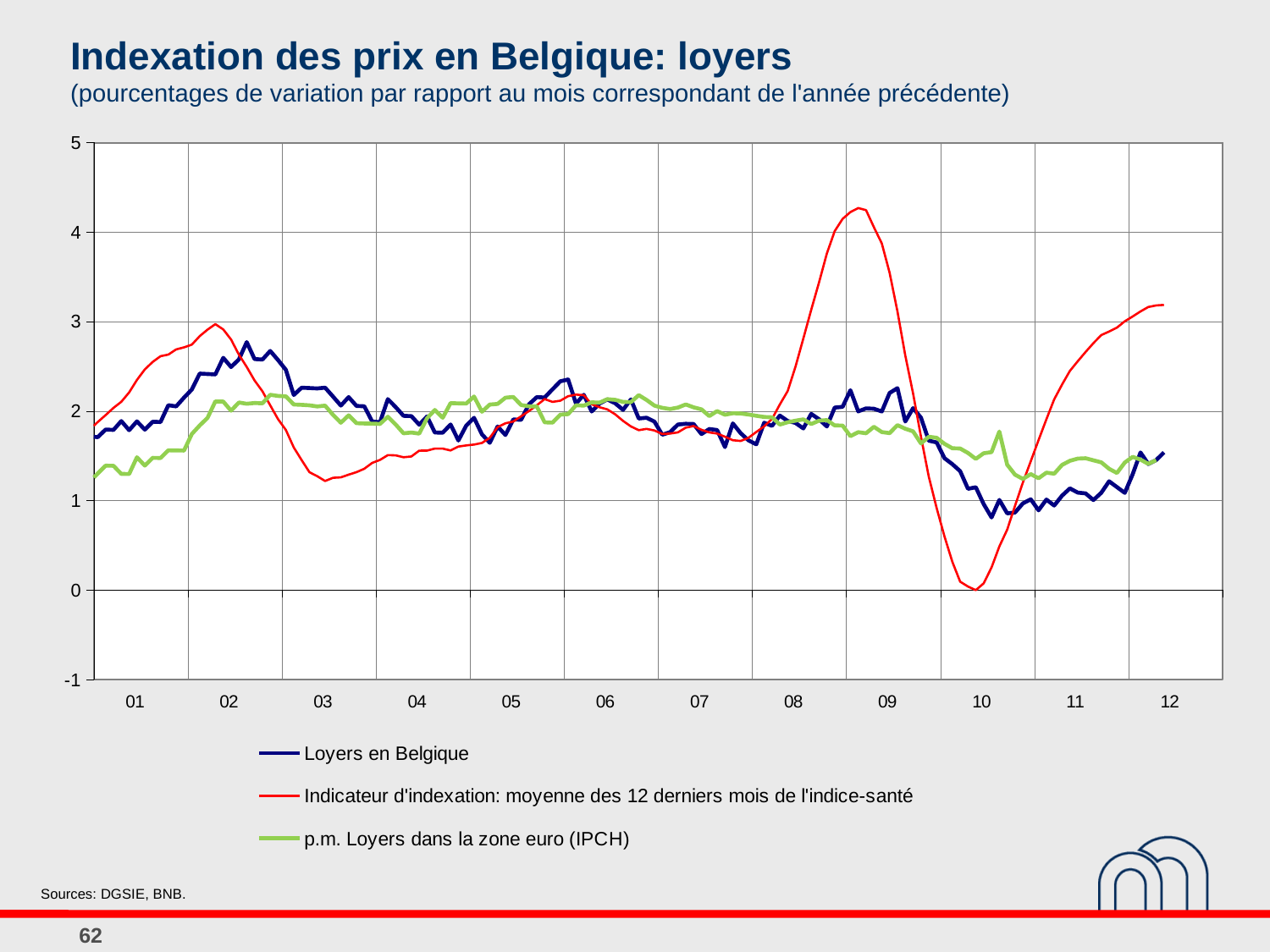
What is the title of the chart? Indexation des prix en Belgique: loyers What kind of chart is shown on the slide? line chart Is the lowest value of 'Indicateur d'indexation' around 03 greater or less than 2? less Which series reaches the highest value on the chart? Indicateur d'indexation: moyenne des 12 derniers mois de l'indice-santé How many series does the legend list? 3 Which series is drawn in green? p.m. Loyers dans la zone euro (IPCH) Is the peak value of the 'Indicateur d'indexation' series around 09 greater or less than 4? greater How many year labels are shown on the x axis? 12 Does the 'Indicateur d'indexation' series rise or fall between 10 and 12? rise Is the value of the 'Indicateur d'indexation' series at 12 greater or less than 3? greater Around 10, which is higher: 'Loyers en Belgique' or 'Indicateur d'indexation'? Loyers en Belgique